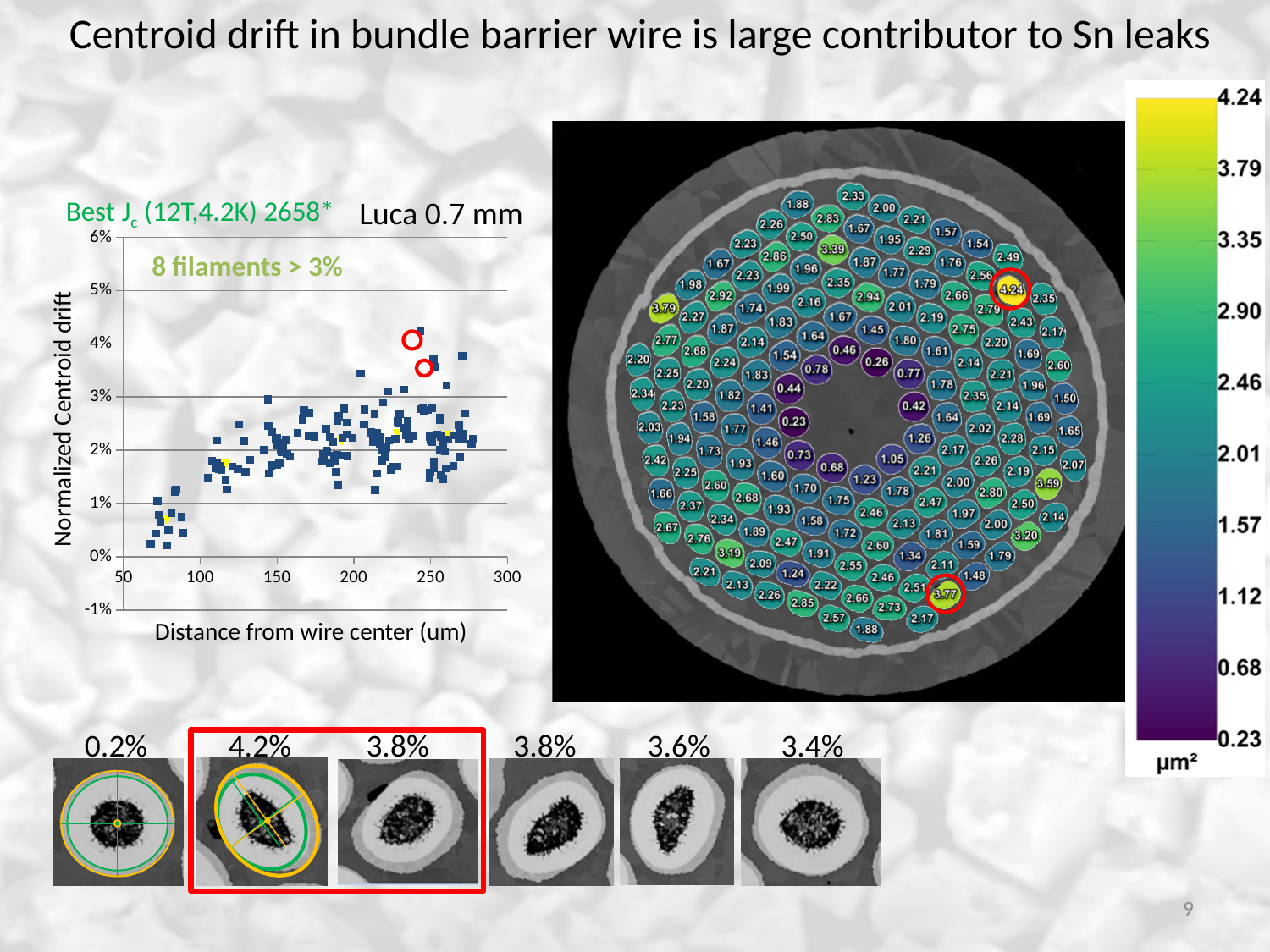
In the scatter chart, is the highest plotted centroid drift value greater or less than 5%? less In the scatter chart, are the points at distances below 100 um greater or less than 2% centroid drift? less According to the annotation on the scatter chart, how many filaments have a centroid drift greater than 3%? 8 In the scatter chart, what is the label of the x axis? Distance from wire center (um) What kind of chart is the 'Luca 0.7 mm' chart on the left of the slide? scatter chart In the scatter chart, what is the label of the y axis? Normalized Centroid drift What is the maximum value shown on the x axis of the scatter chart? 300 In the scatter chart, is the highest plotted centroid drift value greater or less than 4%? greater On the wire cross-section map on the right, what is the maximum value shown on the colour scale? 4.24 On the wire cross-section map on the right, what is the minimum value shown on the colour scale? 0.23 In the scatter chart, do the centroid drift values generally rise or fall as distance from the wire center increases? rise What is the minimum value shown on the y axis of the scatter chart? -1%